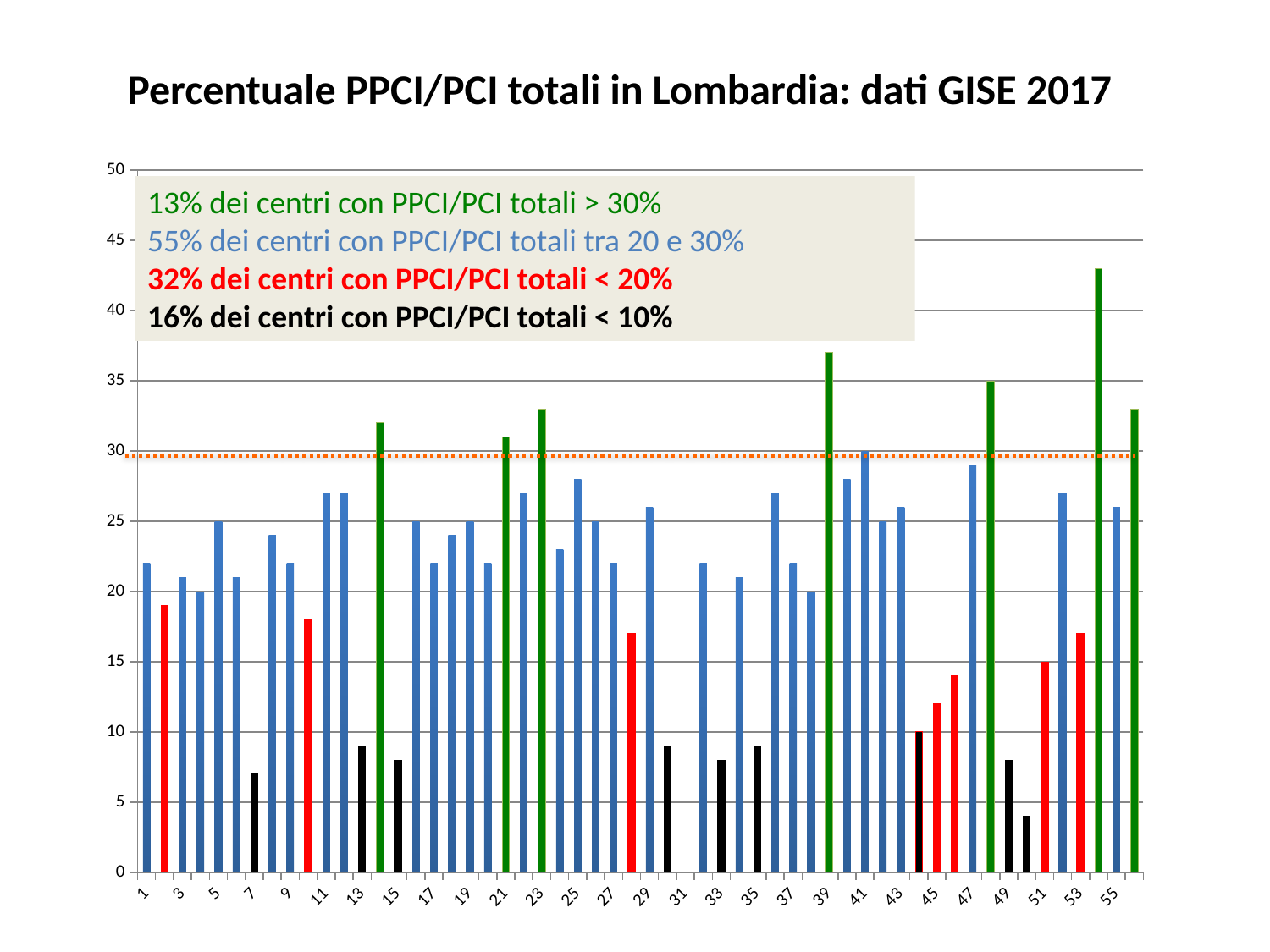
Which is larger, the value for category 54 or the value for category 39? 54 According to the text box on the chart, what percentage of centres have PPCI/PCI totali > 30%? 13% Which category has the highest bar in the chart? 54 Is the value for category 28 greater or less than 20? less Is the value for category 54 greater or less than 40? greater What kind of chart is shown on the slide? bar chart Is the value for category 7 greater or less than 10? less What is the title of the slide's chart? Percentuale PPCI/PCI totali in Lombardia: dati GISE 2017 Which is larger, the value for category 5 or the value for category 7? 5